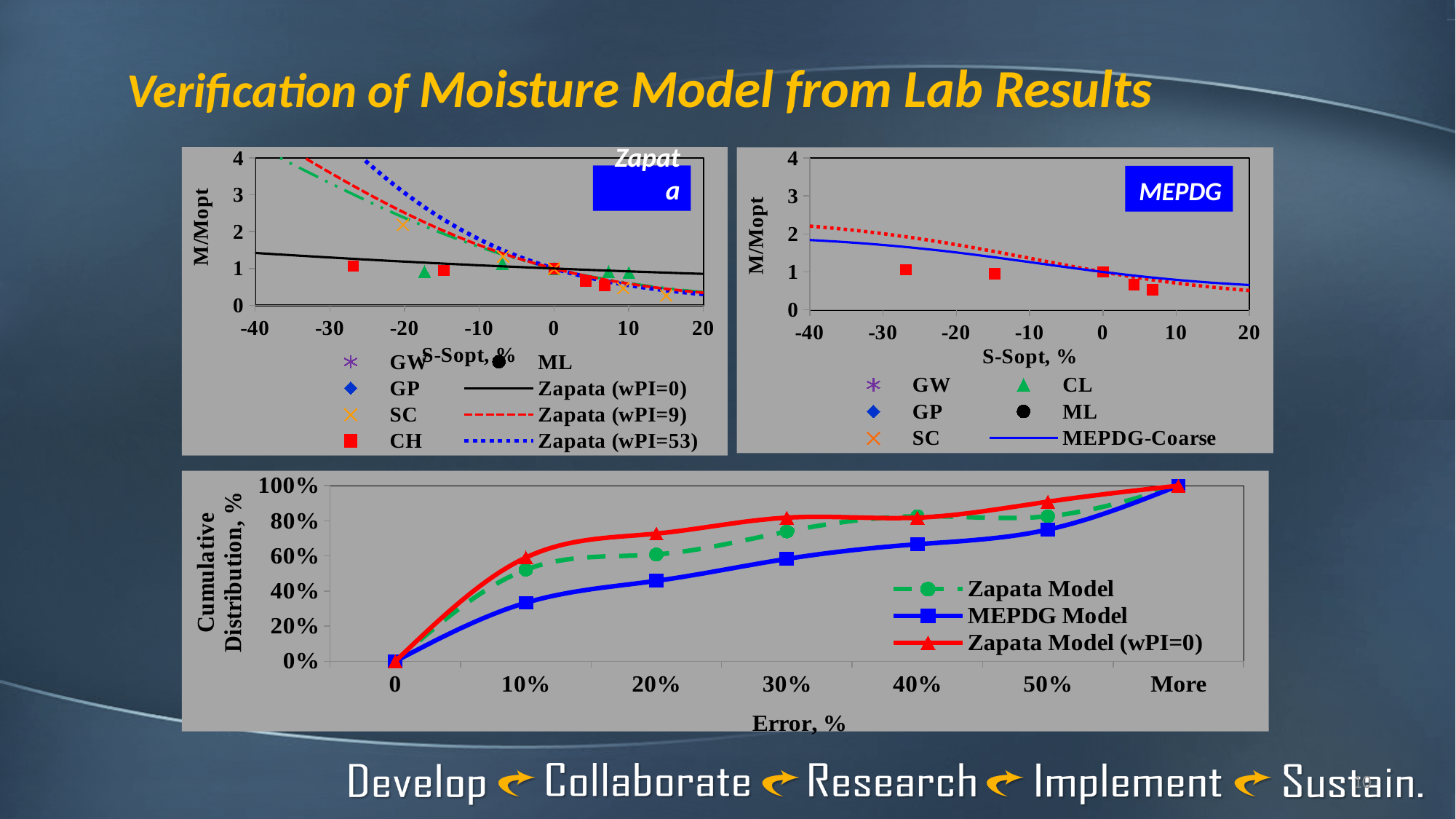
On the bottom chart (Cumulative Distribution vs Error), is the value for the Zapata Model at 10% error greater or less than 40%? greater On the bottom chart (Cumulative Distribution vs Error), how many categories are shown on the x axis? 7 On the bottom chart (Cumulative Distribution vs Error), which series has the lowest value at 20% error? MEPDG Model On the top-left chart (Zapata), how many entries does the legend list? 8 On the bottom chart (Cumulative Distribution vs Error), at 10% error, which is higher: the MEPDG Model or the Zapata Model (wPI=0)? Zapata Model (wPI=0) On the top-left chart (Zapata), does the Zapata (wPI=53) line rise or fall as S-Sopt increases along the x axis? fall On the bottom chart (Cumulative Distribution vs Error), is the value for the MEPDG Model at 10% error greater or less than 40%? less On the bottom chart (Cumulative Distribution vs Error), what is the label of the x axis? Error, % On the bottom chart (Cumulative Distribution vs Error), how many series does the legend list? 3 On the bottom chart (Cumulative Distribution vs Error), is the value for the MEPDG Model at 30% error greater or less than 80%? less On the bottom chart (Cumulative Distribution vs Error), do the values of the MEPDG Model rise or fall as error increases along the x axis? rise